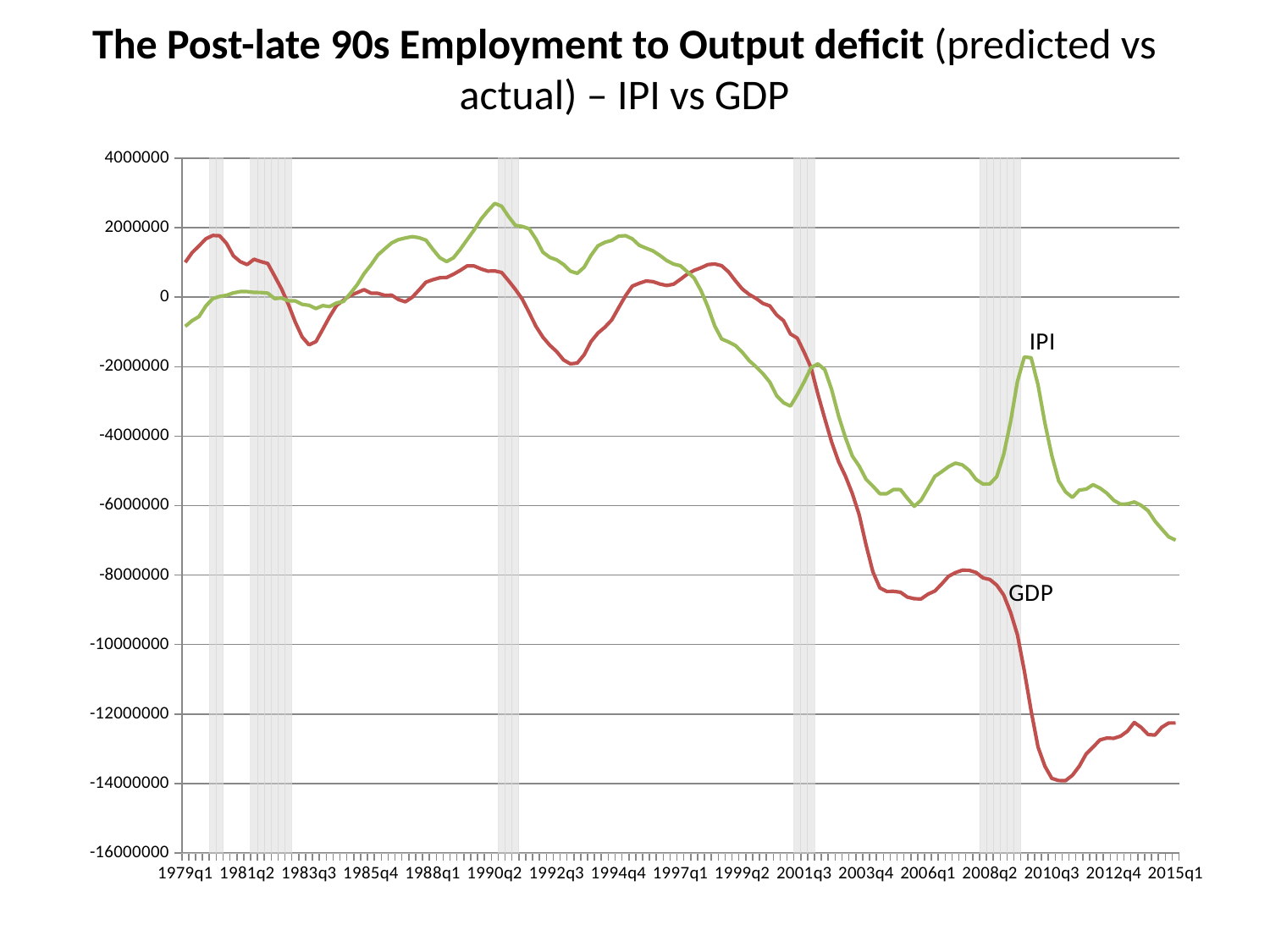
What colour is the GDP line? red Is the value of the GDP line at 2015q1 greater or less than -10000000? less How many series are plotted on the chart? 2 At 1979q1, which line is higher, IPI or GDP? GDP Overall, do the GDP values rise or fall from 1979q1 to 2015q1? fall Is the value of the GDP line at 2003q4 greater or less than -8000000? greater Is the value of the IPI line at 2015q1 greater or less than -8000000? greater What kind of chart is shown on the slide? line chart At 2015q1, which line is higher, IPI or GDP? IPI Which two series are labelled on the chart? IPI and GDP